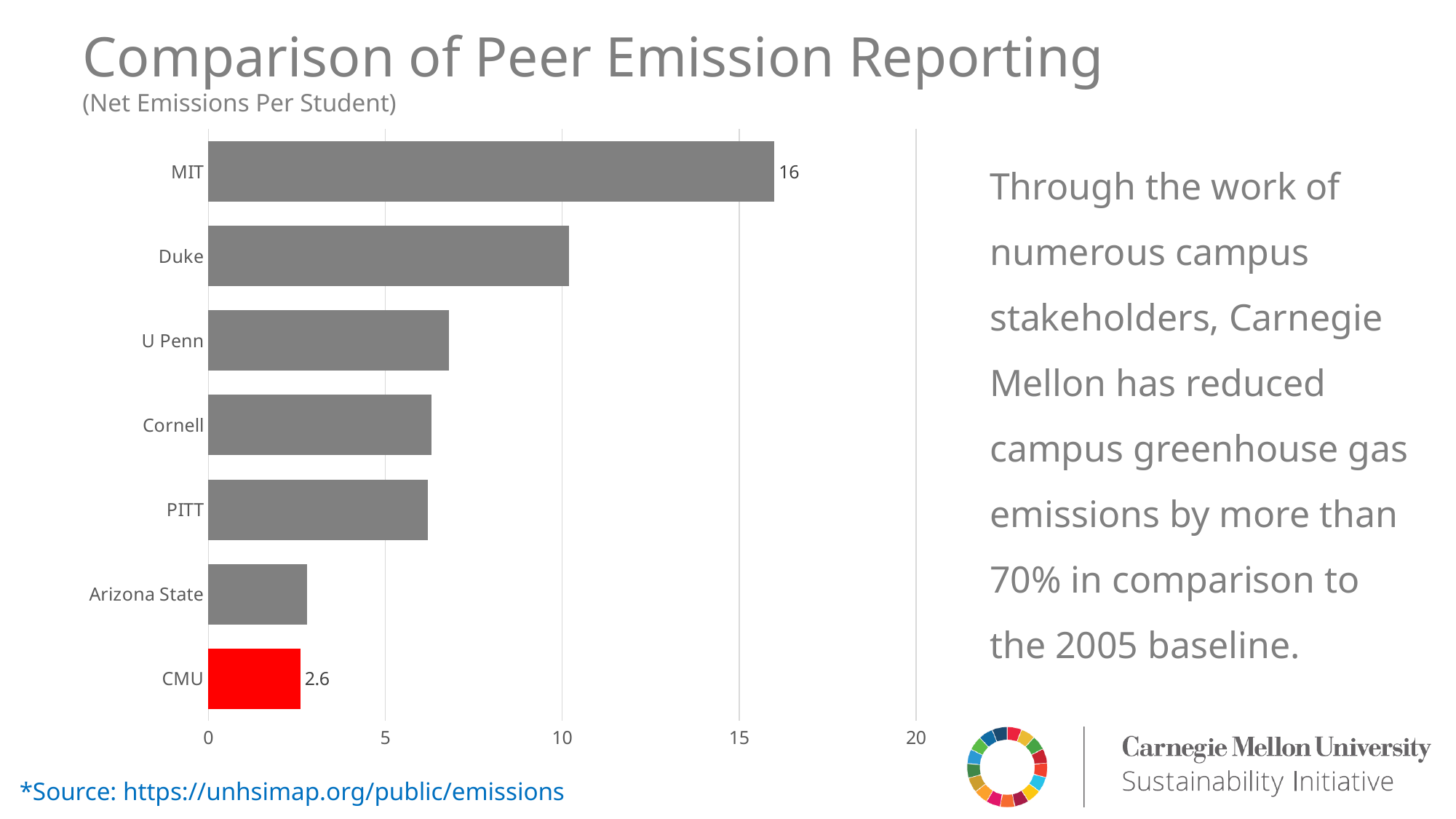
Is the value for Arizona State greater or less than 5? less What is the difference between the values for MIT and CMU? 13.4 What is the net emissions per student value for MIT? 16 Which has a larger value, MIT or Duke? MIT Which bar in the chart is coloured red? CMU Which institution has the highest net emissions per student? MIT What kind of chart is shown on the slide? bar chart What is the net emissions per student value for CMU? 2.6 Is the value for Cornell greater or less than 5? greater Is the value for U Penn greater or less than 10? less How many institutions are shown in the chart? 7 Which has a larger value, Duke or U Penn? Duke